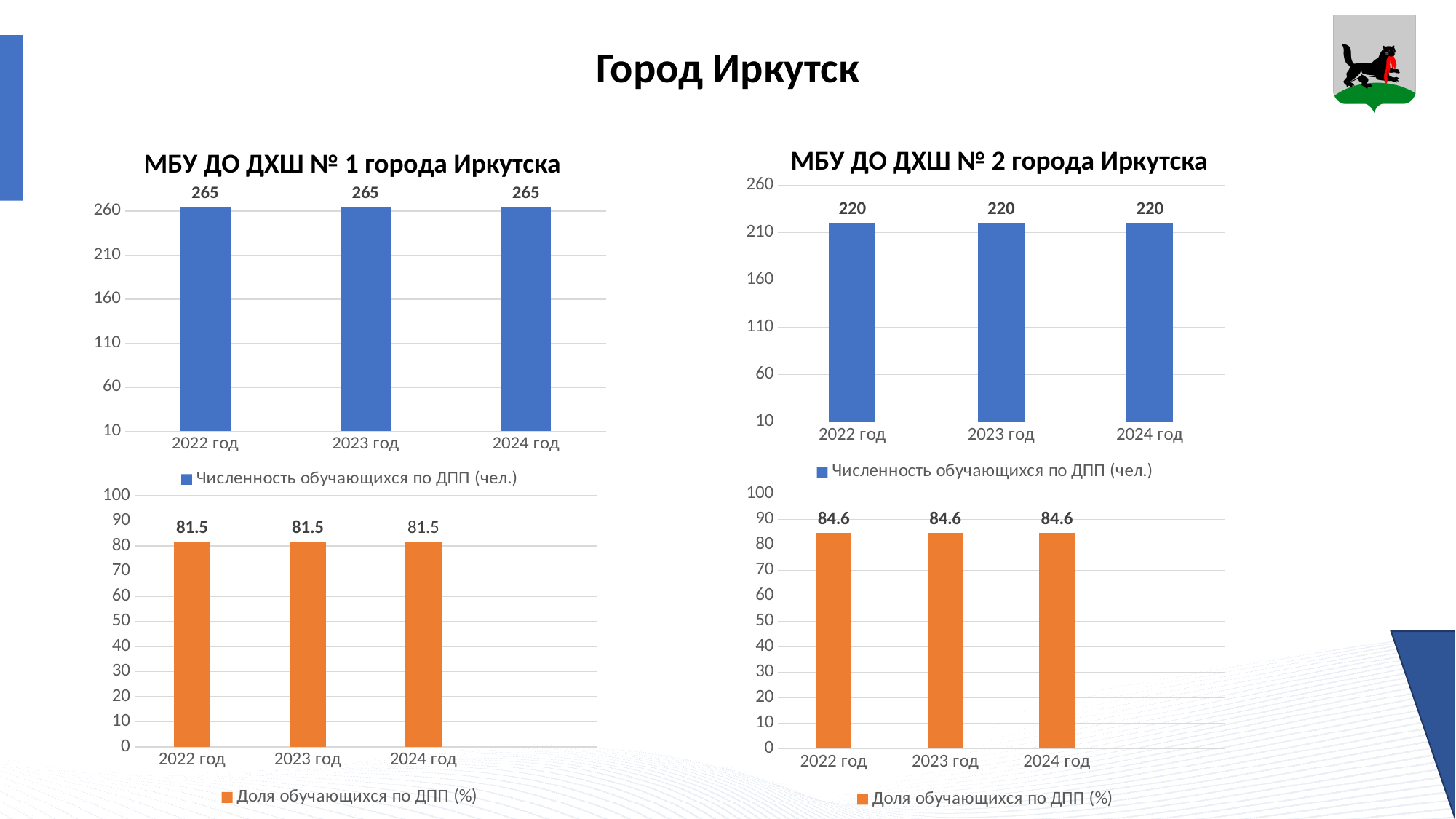
In the bottom-left chart (Доля обучающихся по ДПП (%), under ДХШ № 1), what is the value for 2022 год? 81.5 In the bottom-right chart (Доля обучающихся по ДПП (%), under ДХШ № 2), what is the value for 2023 год? 84.6 In the top-left chart titled 'МБУ ДО ДХШ № 1 города Иркутска', do the values rise, fall or stay the same from 2022 год to 2024 год? stay the same What kind of chart is the bottom-left chart (Доля обучающихся по ДПП (%), under ДХШ № 1)? bar chart In the bottom-right chart (Доля обучающихся по ДПП (%), under ДХШ № 2), do the values rise, fall or stay the same across the years? stay the same Which is larger: the 2022 год value in the top-left chart (ДХШ № 1) or the 2022 год value in the top-right chart (ДХШ № 2)? ДХШ № 1 (265) In the top-right chart titled 'МБУ ДО ДХШ № 2 города Иркутска', what is the value for 2024 год? 220 What is the legend entry of the bottom-right chart under 'МБУ ДО ДХШ № 2 города Иркутска'? Доля обучающихся по ДПП (%) In the top-left chart titled 'МБУ ДО ДХШ № 1 города Иркутска', what is the value for 2023 год? 265 What is the difference between the 2024 год value in the top-left chart (ДХШ № 1, 265) and the 2024 год value in the top-right chart (ДХШ № 2, 220)? 45 How many categories (years) are shown on the x axis of the top-right chart titled 'МБУ ДО ДХШ № 2 города Иркутска'? 3 How many series does the legend of the top-left chart titled 'МБУ ДО ДХШ № 1 города Иркутска' list? 1